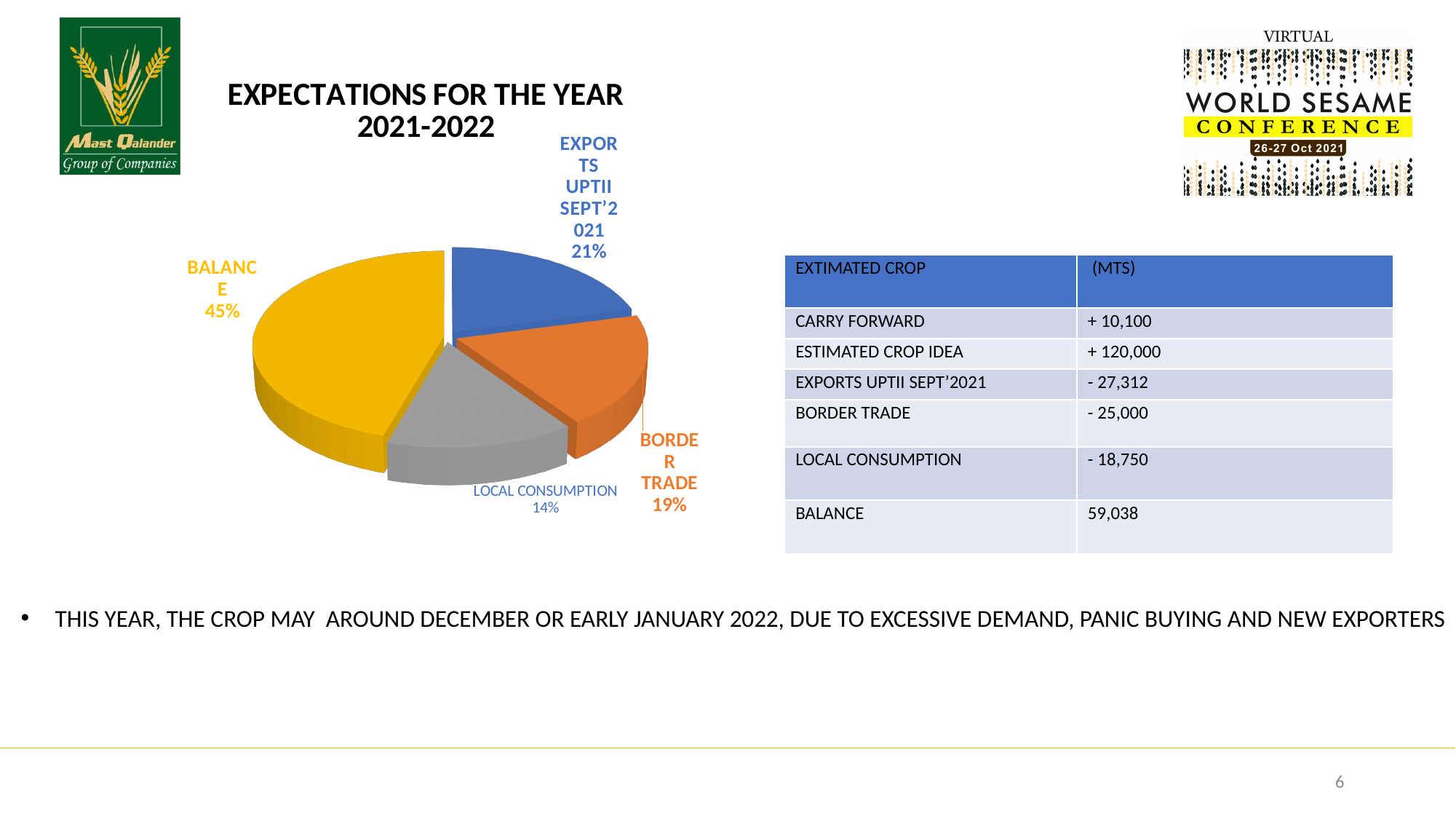
What type of chart is shown on the slide? Pie chart What percentage is shown for LOCAL CONSUMPTION? 14% What is the title of the chart? EXPECTATIONS FOR THE YEAR 2021-2022 How many slices does the pie chart have? 4 Which is larger, EXPORTS UPTII SEPT'2021 or BORDER TRADE? EXPORTS UPTII SEPT'2021 Which slice of the pie chart is the smallest? LOCAL CONSUMPTION Which slice of the pie chart is the largest? BALANCE What percentage is shown for EXPORTS UPTII SEPT'2021? 21% What percentage is shown for BORDER TRADE? 19% What colour is the BALANCE slice of the pie chart? Yellow What is the difference in percentage points between BALANCE and LOCAL CONSUMPTION? 31 What share of the pie does BALANCE represent? 45%